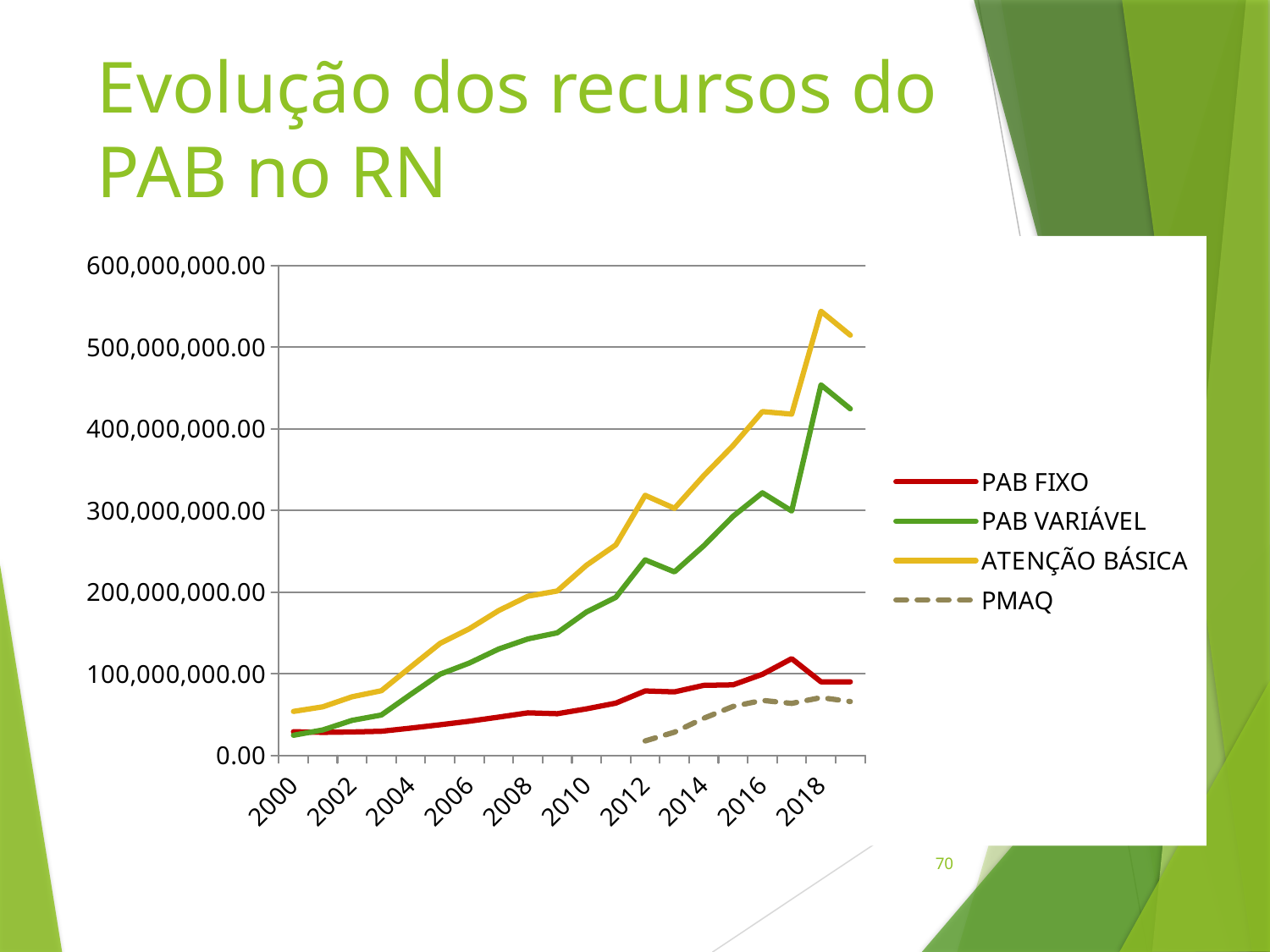
Which series reaches the highest value on the chart? ATENÇÃO BÁSICA Is the value for PAB FIXO in 2000 greater or less than 100,000,000.00? less Is the value for ATENÇÃO BÁSICA in 2018 greater or less than 500,000,000.00? greater What kind of chart is shown on the slide? line chart Which series is drawn with a dashed line? PMAQ Is the value for PMAQ in 2012 greater or less than 100,000,000.00? less What is the title of the slide containing the chart? Evolução dos recursos do PAB no RN In 2018, which is larger: ATENÇÃO BÁSICA or PAB FIXO? ATENÇÃO BÁSICA How many series does the legend list? 4 Does the ATENÇÃO BÁSICA series generally rise or fall from 2000 to 2018? rise